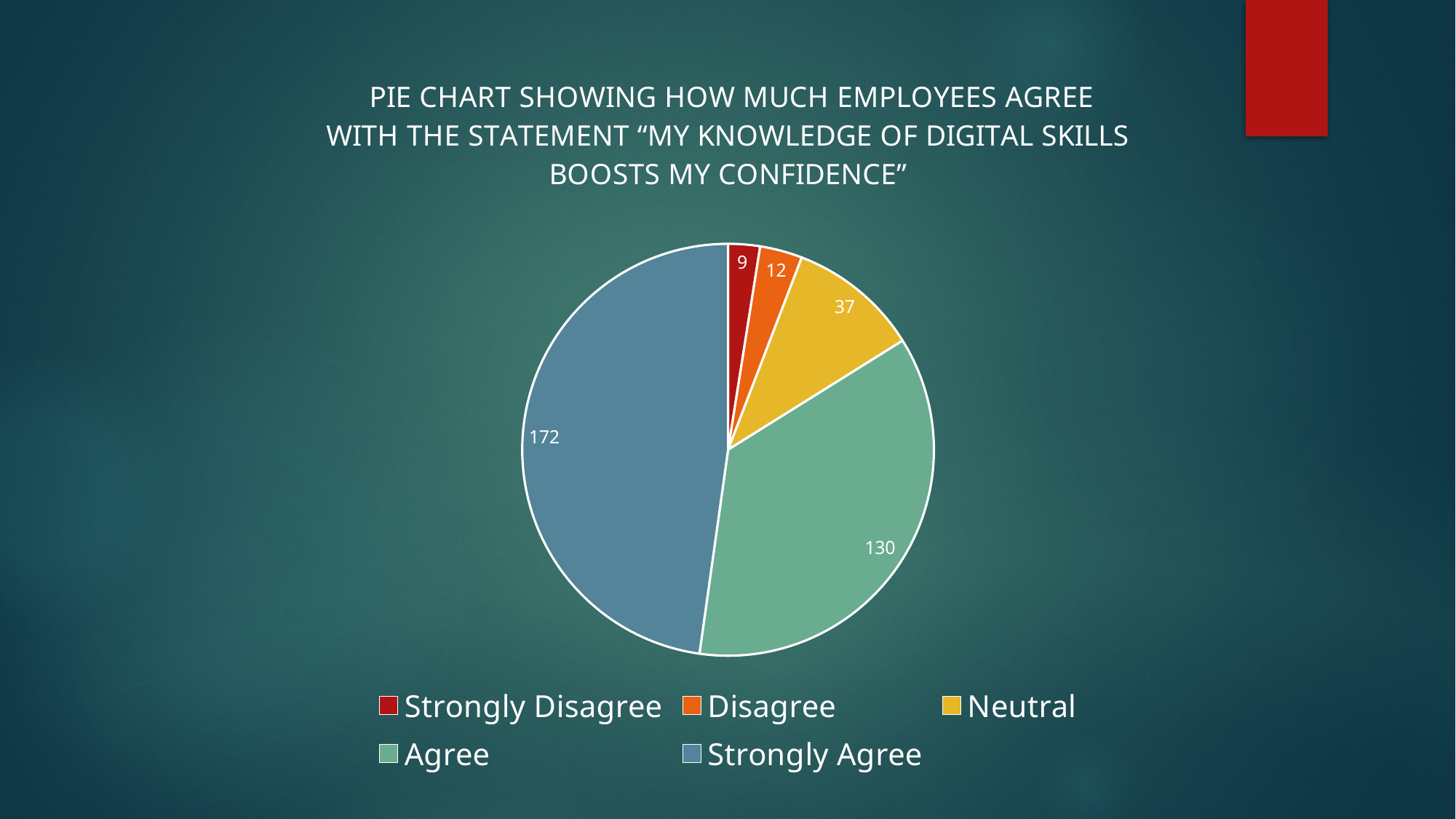
How many employees responded "Agree"? 130 What is the value for the "Neutral" slice? 37 Which response category has the smallest slice? Strongly Disagree What is the difference between the "Strongly Agree" and "Agree" values? 42 What is the value for the "Disagree" slice? 12 How many categories does the pie chart have? 5 What is the total of all the slices in the pie chart? 360 What colour is the "Strongly Agree" slice in the legend? Blue Which is larger, the "Neutral" slice or the "Disagree" slice? Neutral How many employees responded "Strongly Agree"? 172 Which response category has the largest slice? Strongly Agree What type of chart is shown on the slide? Pie chart